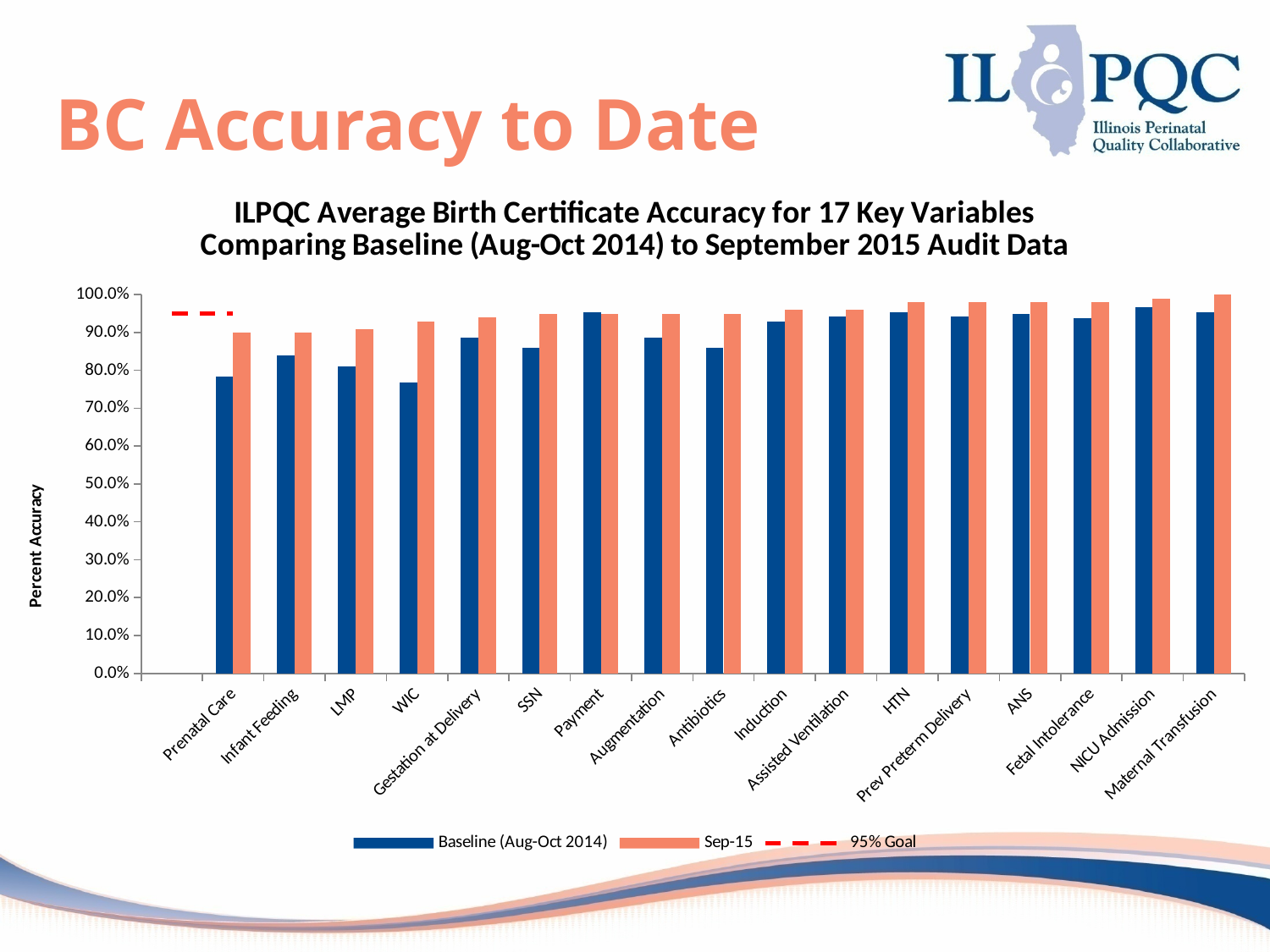
Is the Sep-15 value for Maternal Transfusion greater or less than 90.0%? greater What kind of chart is shown on the slide? bar chart For Prenatal Care, which is larger: the Baseline (Aug-Oct 2014) value or the Sep-15 value? Sep-15 Is the Baseline (Aug-Oct 2014) value for WIC greater or less than 80.0%? less What does the red dashed line in the chart represent? 95% Goal Is the Baseline (Aug-Oct 2014) value for Infant Feeding greater or less than 80.0%? greater How many entries does the legend list? 3 Which has the larger Baseline (Aug-Oct 2014) value: Infant Feeding or Payment? Payment What is the label on the y axis of the chart? Percent Accuracy How many categories (key variables) are shown along the x axis? 17